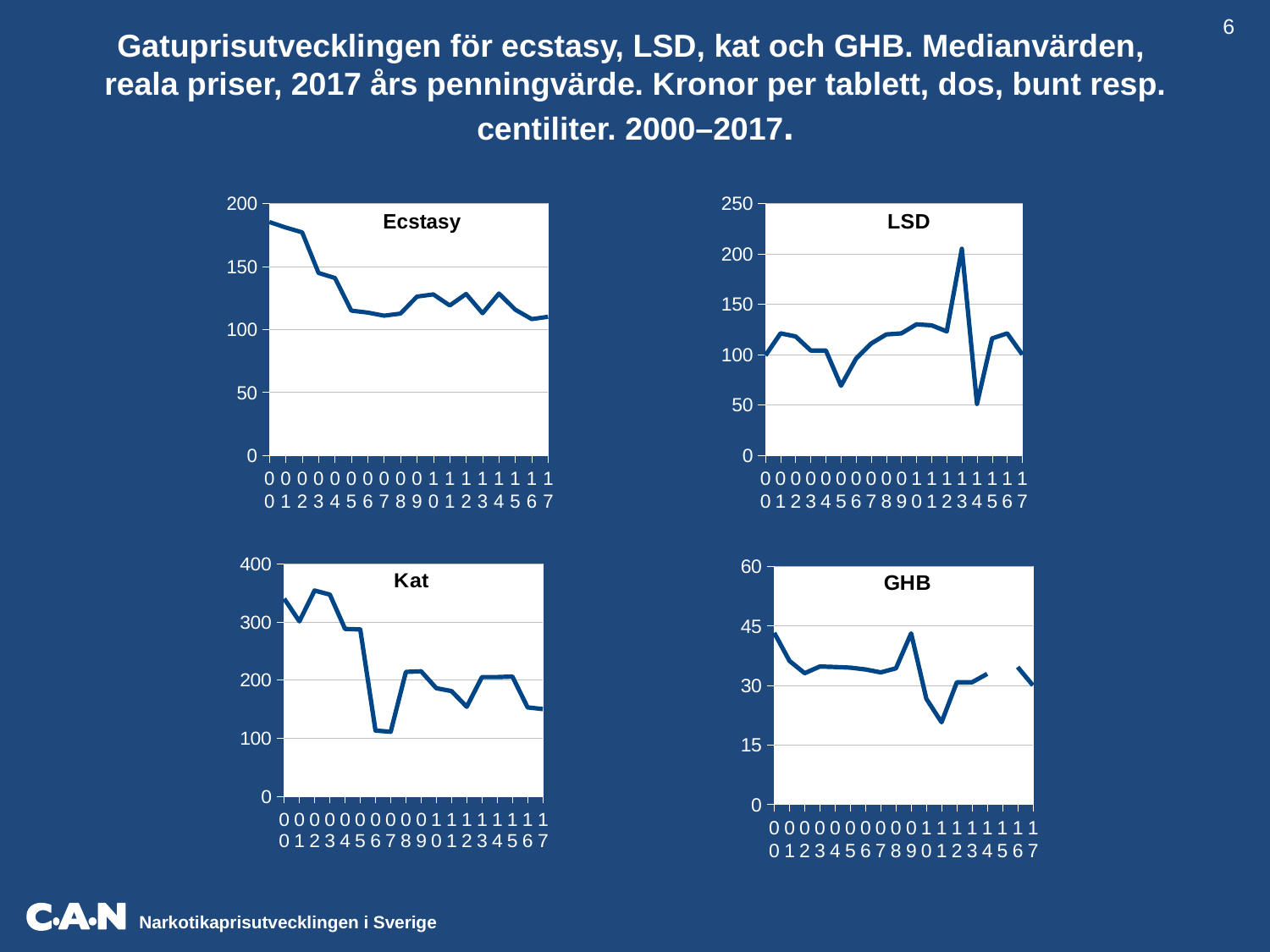
In the Kat chart, which year has the highest value? 2002 In the LSD chart, which year has the highest value? 2013 In the Kat chart, is the value for 2007 greater or less than 200? less In the Ecstasy chart, is the value for 2000 greater or less than 150? greater In the LSD chart, is the value for 2015 greater or less than 100? greater In the Ecstasy chart, do the values overall rise or fall from 2000 to 2017? fall What kind of chart is the Ecstasy chart? line chart In the Ecstasy chart, how many years are plotted along the x axis? 18 How many charts are shown on the slide? 4 Which of the four charts has the highest value shown at the top of its y axis? Kat In the LSD chart, which year has the lowest value? 2014